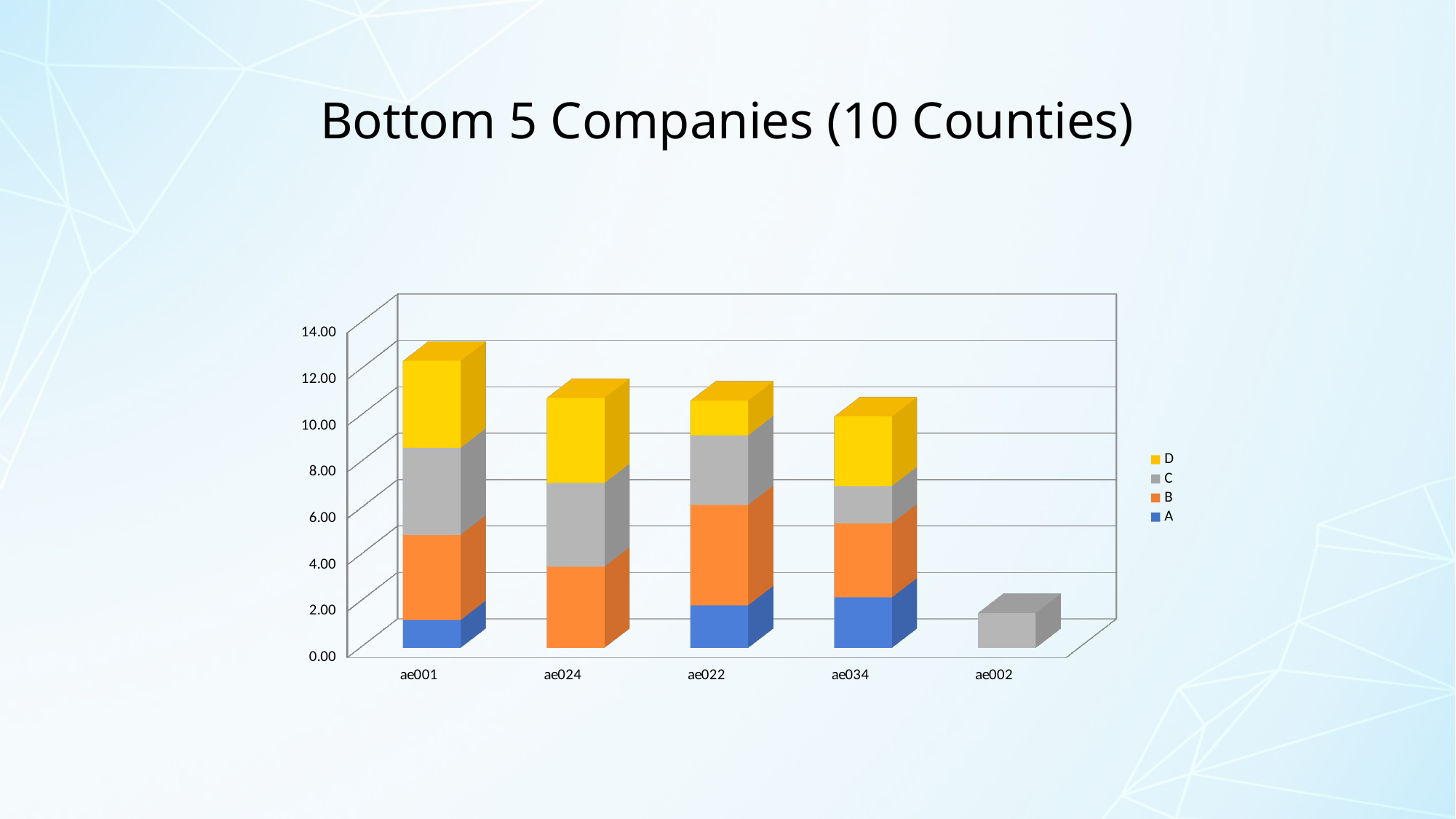
Is the total stacked value for ae002 greater or less than 4.00? less Which company has the tallest stacked bar? ae001 How many series does the legend list? 4 Is the total stacked value for ae024 greater or less than 10.00? greater Which series is shown in yellow in the legend? D How many companies (categories) are shown on the x axis? 5 Which has the larger total stacked value, ae001 or ae034? ae001 Do the stacked bar totals generally rise or fall from left to right along the x axis? fall What kind of chart is shown on the slide? Stacked bar chart Is the total stacked value for ae001 greater or less than 12.00? greater What is the title of the chart slide? Bottom 5 Companies (10 Counties) Which company has the shortest stacked bar? ae002